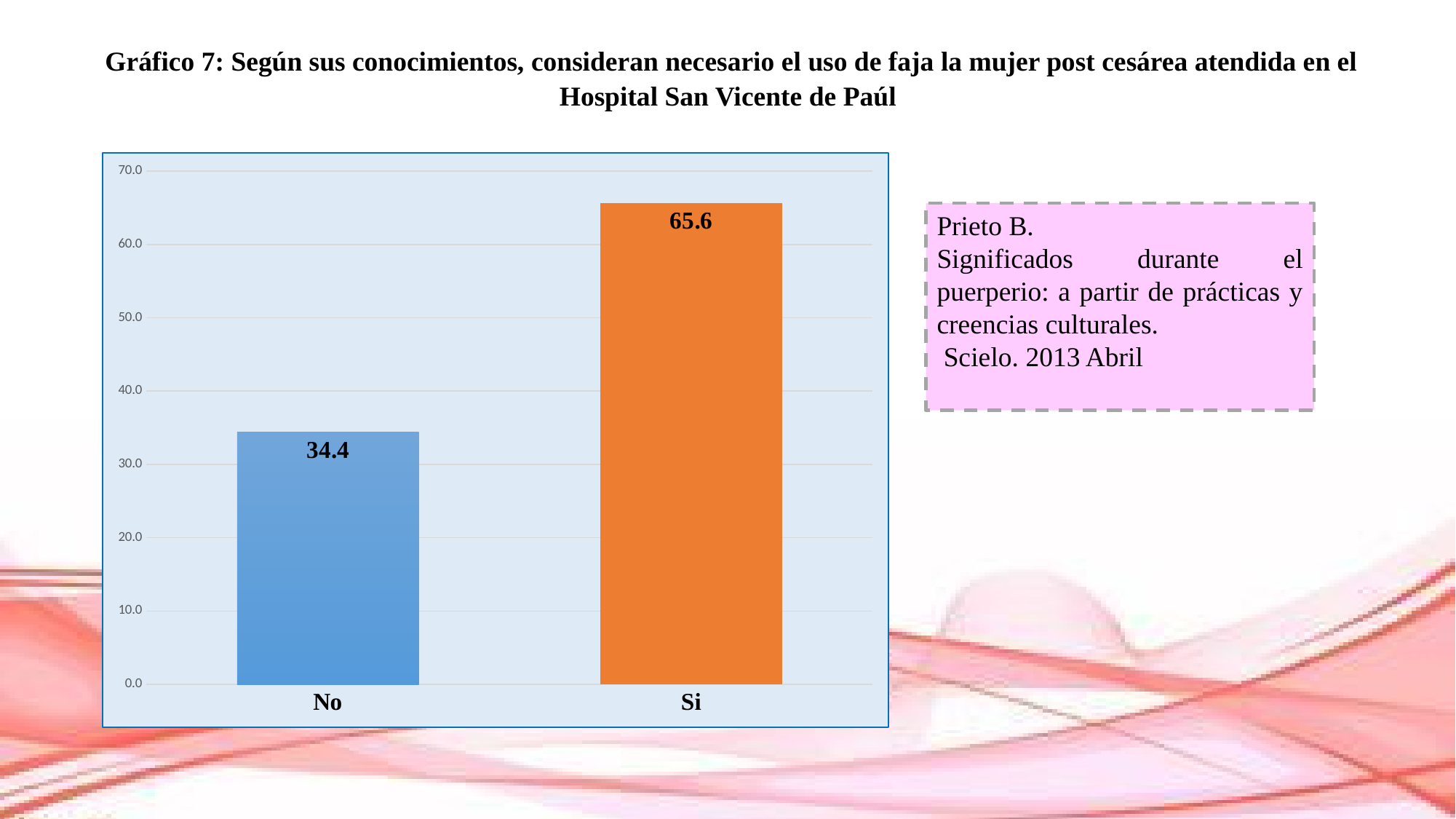
What colour is the bar for "Si"? orange How many categories are shown on the x axis? 2 Is the value for "No" greater or less than 40.0? less What is the value for "Si"? 65.6 Is the value for "Si" greater or less than 60.0? greater Which category has the lowest value? No Which category has the highest value? Si Which is larger, the value for "No" or the value for "Si"? Si What is the difference between the values for "Si" and "No"? 31.2 What kind of chart is shown on the slide? bar chart What is the value for "No"? 34.4 What is the highest tick value shown on the y axis? 70.0